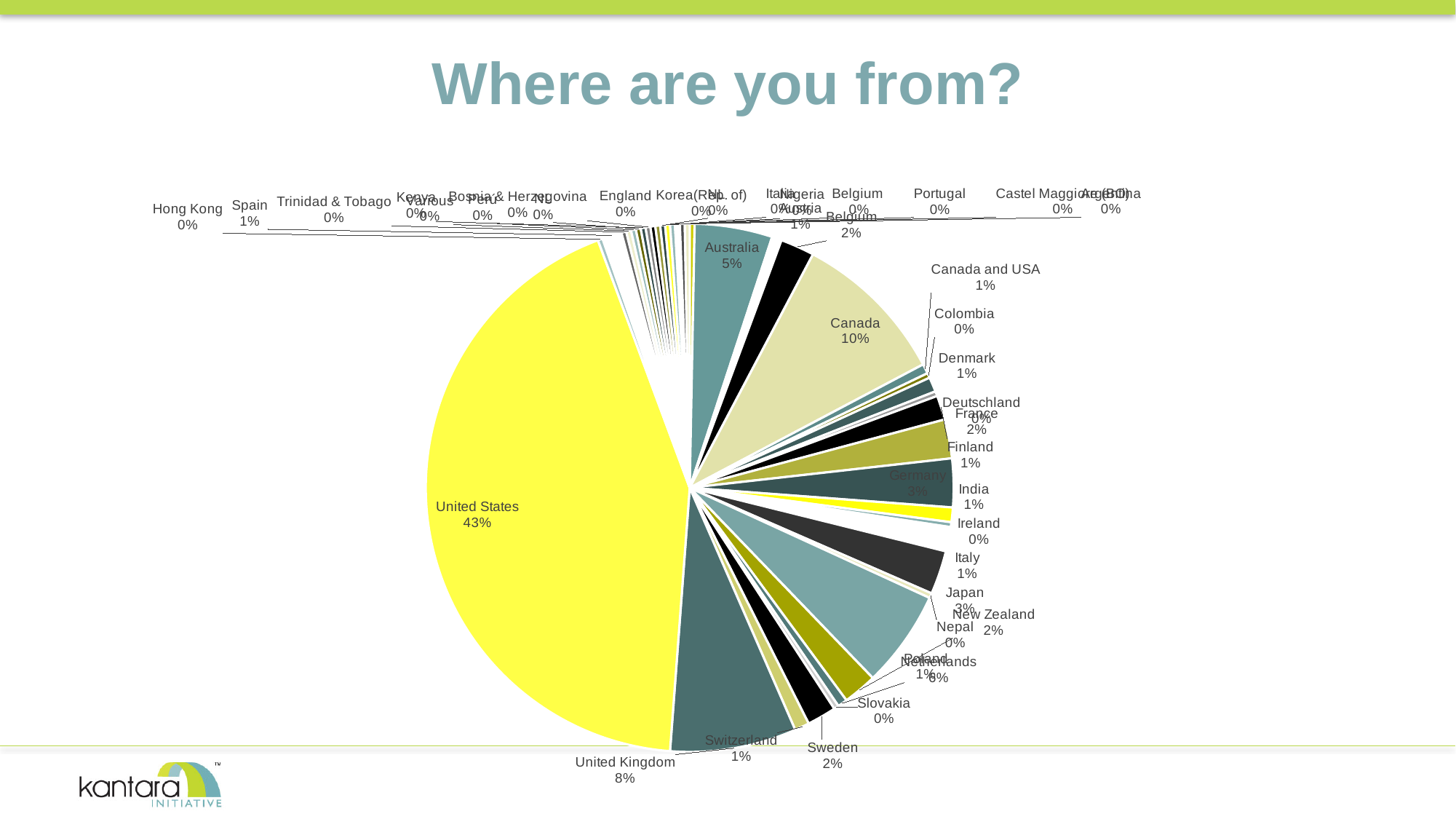
What is the difference in percentage points between Canada and Australia? 5 Which country has the largest share of the pie? United States What percentage is shown for Canada? 10% What percentage is shown for Australia? 5% What percentage is shown for Sweden? 2% What is the difference in percentage points between the United States and Canada? 33 What share of the pie does the United States slice represent? 43% What percentage is shown for the United Kingdom? 8% What kind of chart is shown on the slide? pie chart What percentage is shown for Japan? 3% Which has a larger share, Canada or the United Kingdom? Canada What is the title of the chart? Where are you from?